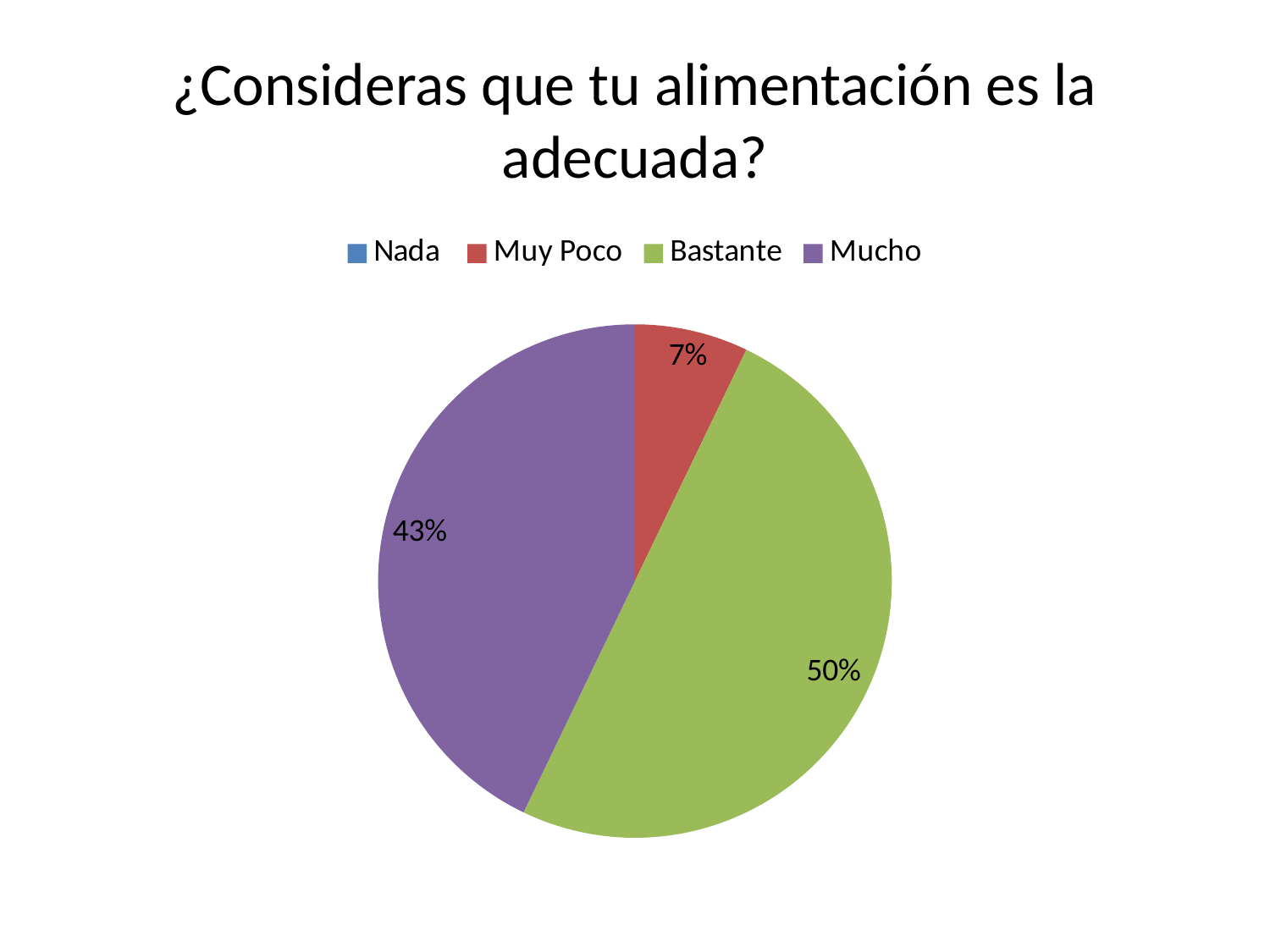
What colour is the Bastante slice? green What is the difference in percentage points between the Bastante slice and the Mucho slice? 7 What is the title of the chart? ¿Consideras que tu alimentación es la adecuada? Which slice is larger, Mucho or Muy Poco? Mucho What kind of chart is shown on the slide? pie chart What percentage of the pie is labelled for Bastante? 50% Which category with a visible slice has the smallest share of the pie? Muy Poco How many entries does the legend list? 4 What percentage of the pie is labelled for Mucho? 43% What is the difference in percentage points between the Mucho slice and the Muy Poco slice? 36 What percentage of the pie is labelled for Muy Poco? 7% Which category has the largest slice of the pie? Bastante